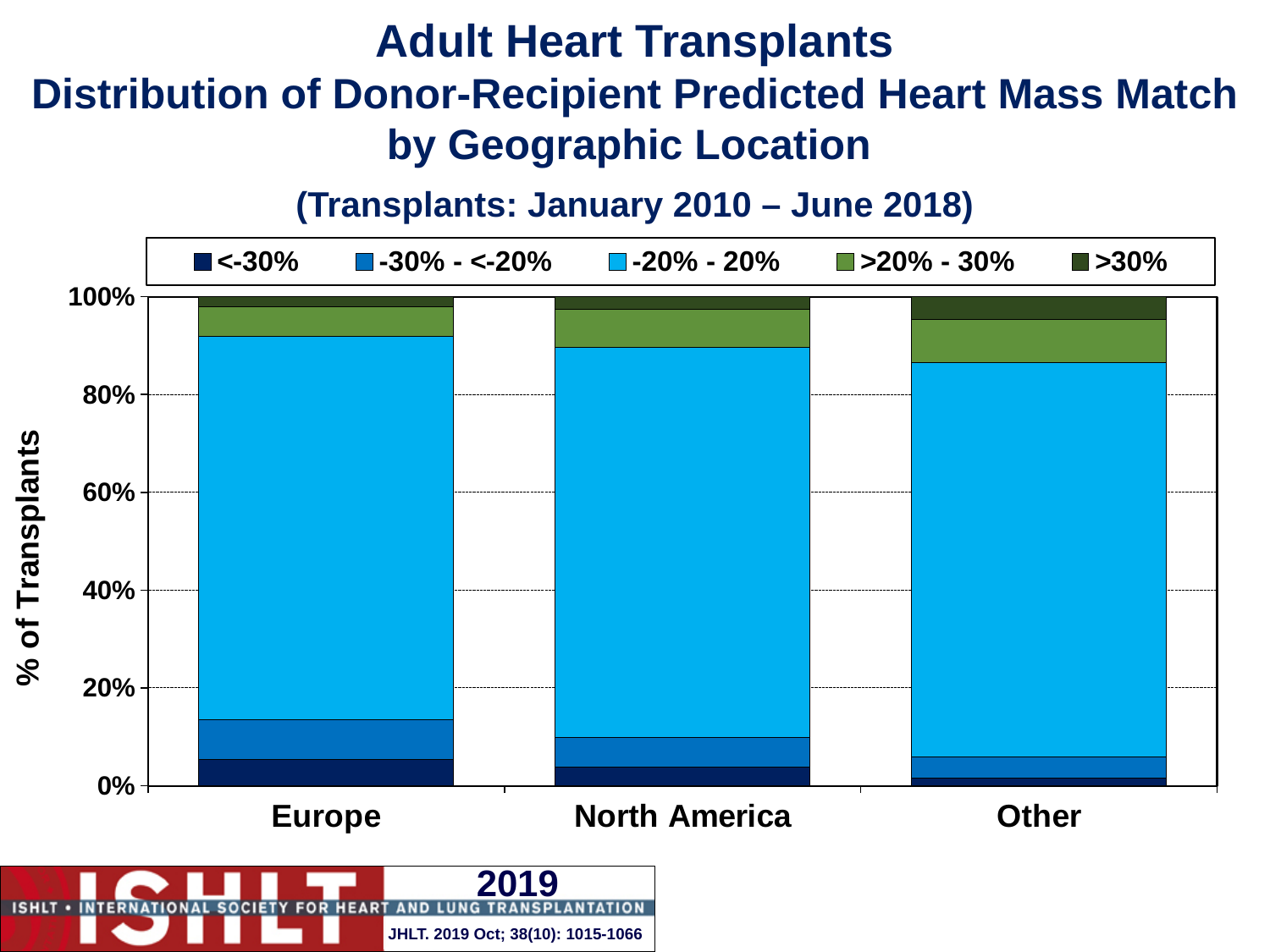
Is the <-30% segment larger for Europe or for Other? Europe What transplant period is given in the chart subtitle? January 2010 – June 2018 Which geographic location has the largest >30% segment? Other Which geographic location has the largest -30% - <-20% segment? Europe Which geographic location has the smallest <-30% segment? Other How many geographic locations are shown on the x axis? 3 What is the label of the y axis? % of Transplants How many series does the legend list? 5 What kind of chart is shown on the slide? stacked bar chart Is the <-30% segment for North America greater or less than 20% of the bar? less Which geographic location has the largest <-30% segment? Europe Is the -20% - 20% segment for Other greater or less than 60% of the bar? greater